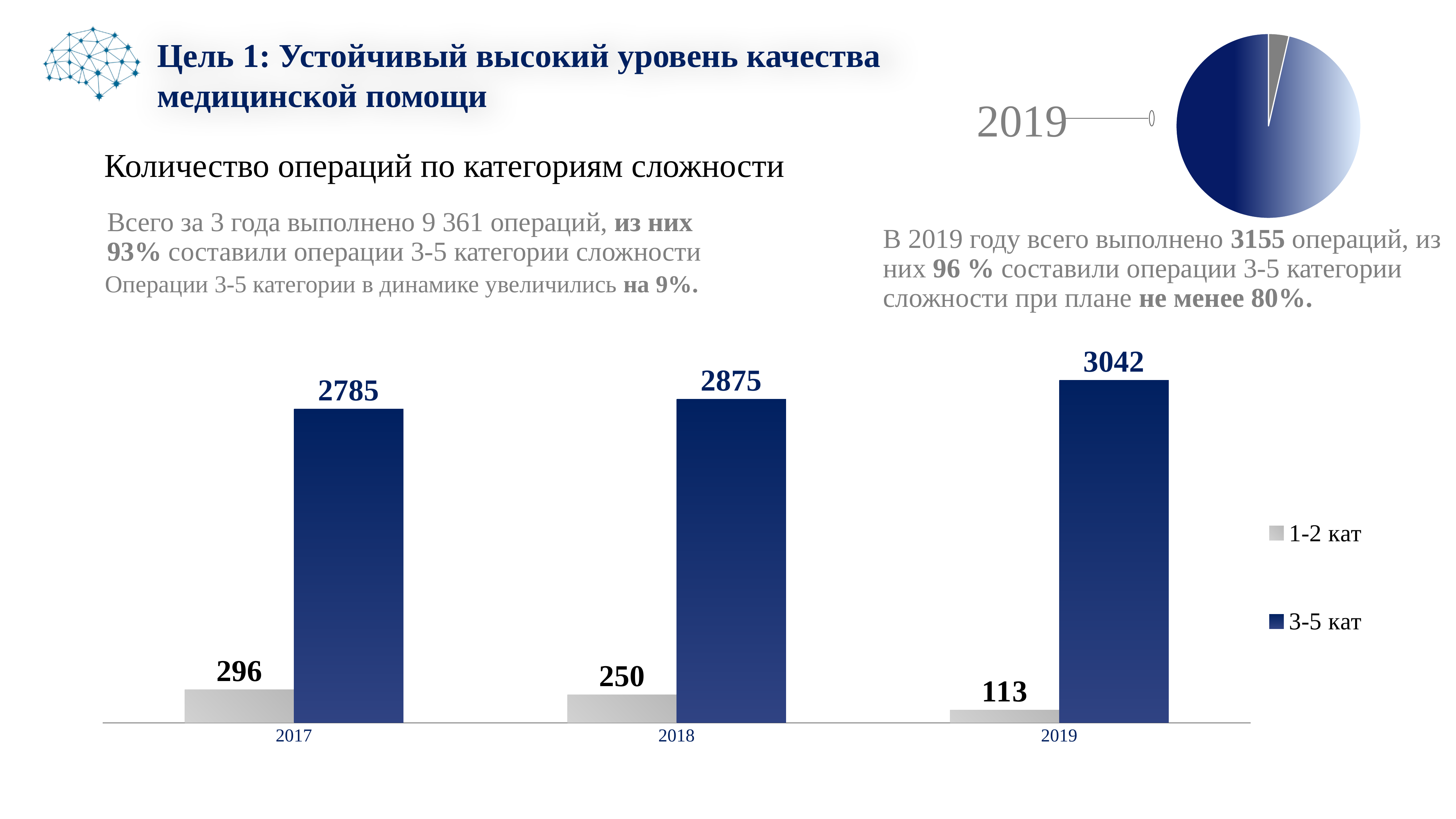
In the bar chart 'Количество операций по категориям сложности', what is the value for '1-2 кат' in 2017? 296 In the bar chart 'Количество операций по категориям сложности', what is the difference between the '3-5 кат' values for 2019 and 2018? 167 What kind of chart is the chart in the top right of the slide, next to the label '2019'? pie chart In the bar chart 'Количество операций по категориям сложности', what is the value for '3-5 кат' in 2019? 3042 In the bar chart 'Количество операций по категориям сложности', do the '1-2 кат' values rise or fall from 2017 to 2019? fall In the bar chart 'Количество операций по категориям сложности', what is the value for '3-5 кат' in 2018? 2875 In the bar chart 'Количество операций по категориям сложности', which year has the highest value for '3-5 кат'? 2019 In the bar chart 'Количество операций по категориям сложности', which year has the lowest value for '1-2 кат'? 2019 In the bar chart 'Количество операций по категориям сложности', how many series does the legend list? 2 In the bar chart 'Количество операций по категориям сложности', how many years are shown on the x axis? 3 In the bar chart 'Количество операций по категориям сложности', which is larger: the '1-2 кат' value for 2017 or for 2018? 2017 What kind of chart is the chart titled 'Количество операций по категориям сложности'? bar chart